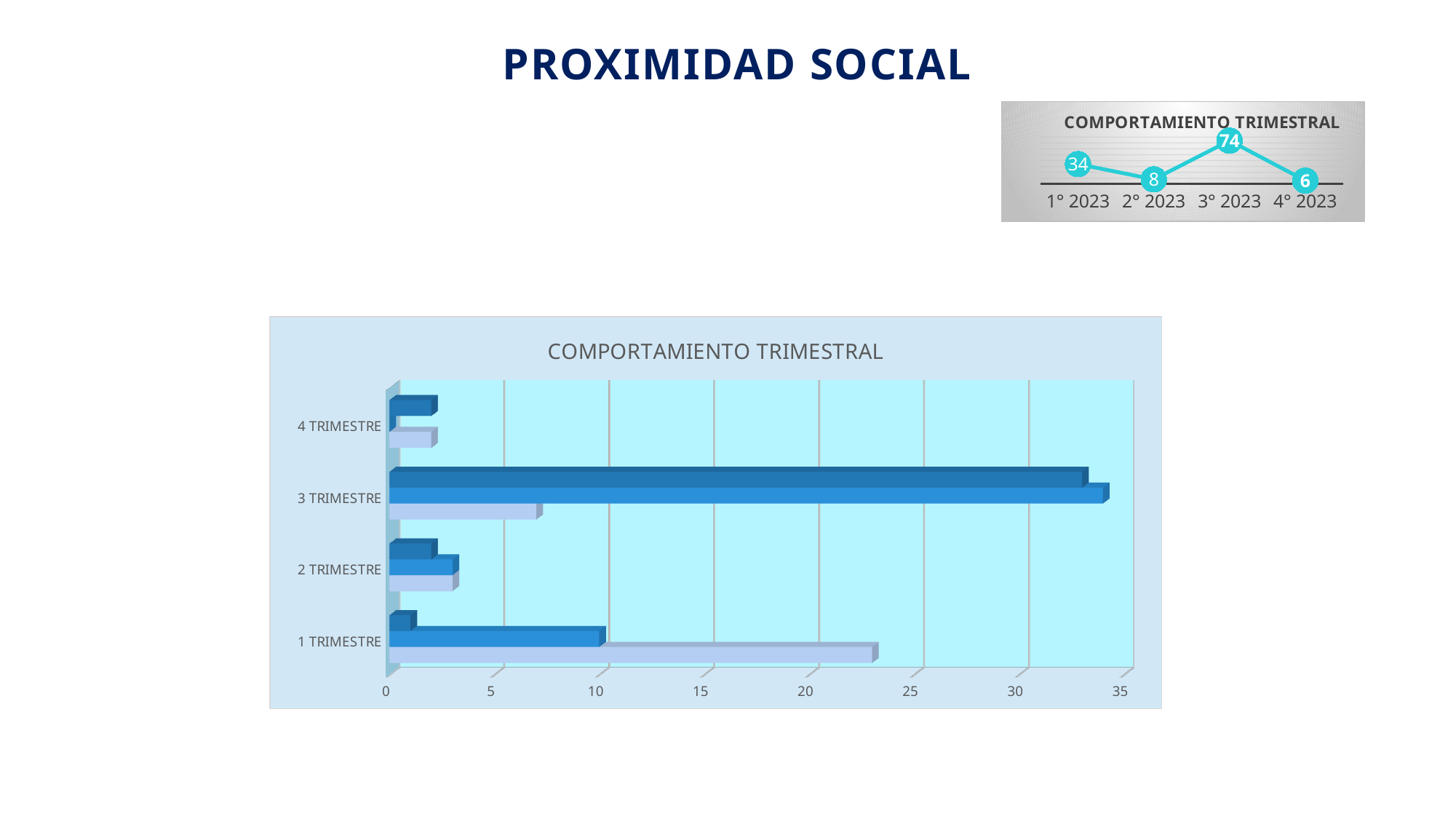
In the line chart at the top right, which is larger, the value for 1° 2023 or the value for 2° 2023? 1° 2023 In the line chart at the top right, what is the value for 1° 2023? 34 How many data points are plotted in the line chart at the top right? 4 In the line chart at the top right, which quarter has the highest value? 3° 2023 In the line chart at the top right, what is the value for 4° 2023? 6 How many categories are shown on the vertical axis of the bar chart at the bottom? 4 In the bar chart at the bottom, which category has the longest bar? 3 TRIMESTRE In the line chart at the top right, what is the value for 3° 2023? 74 In the line chart at the top right, which quarter has the lowest value? 4° 2023 In the line chart at the top right, what is the difference between the values for 3° 2023 and 2° 2023? 66 What kind of chart is the large chart at the bottom of the slide? Bar chart In the bar chart at the bottom, is the longest bar for 3 TRIMESTRE greater or less than 30? greater